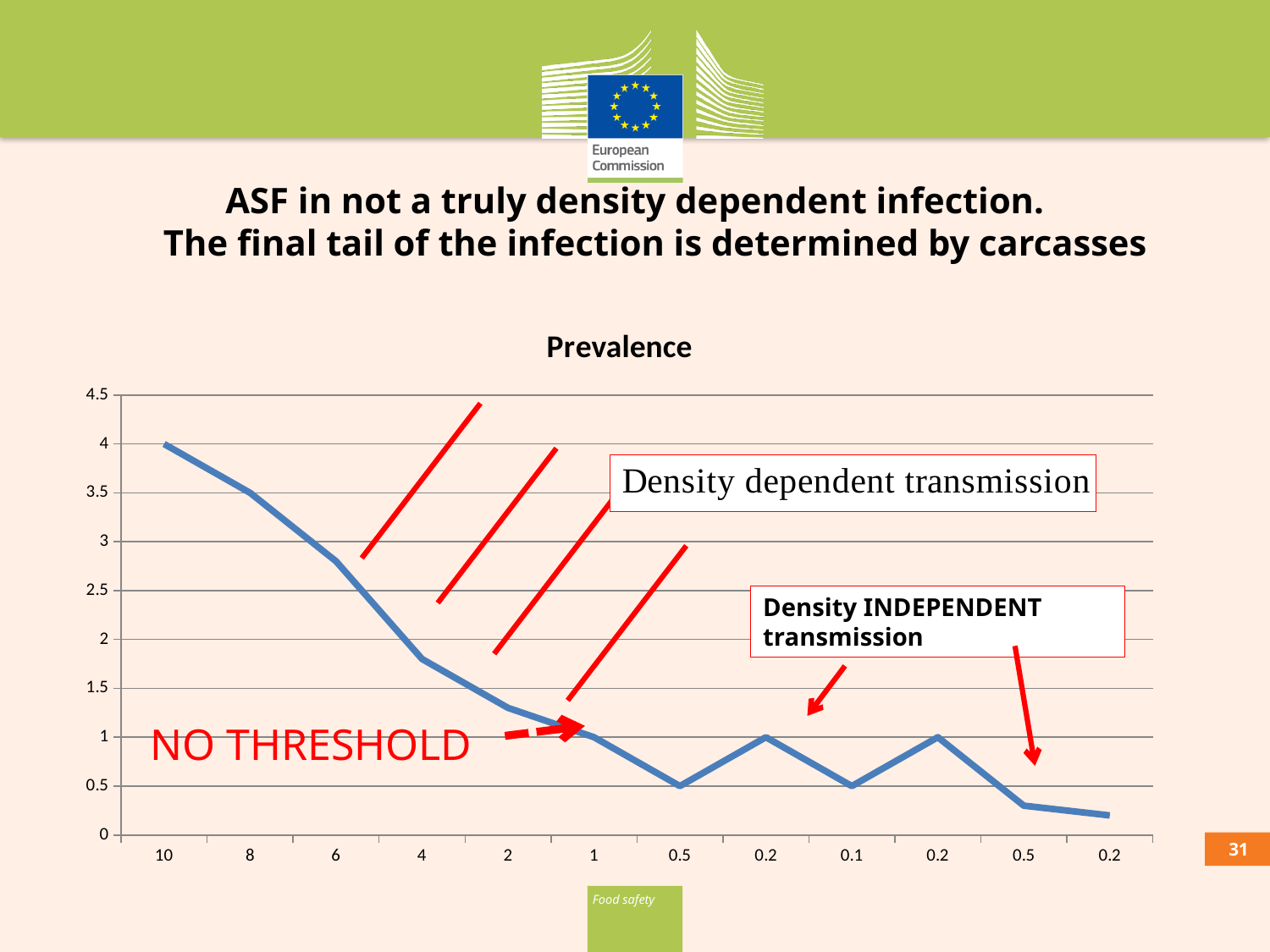
What is the prevalence value at the x-axis category 1? 1 Is the prevalence value at x-axis category 4 greater or less than 2? less How many data points are plotted on the line? 12 At which x-axis category is the prevalence highest? 10 Does the prevalence generally rise or fall from left to right along the x axis? fall What is the prevalence value at the x-axis category 8? 3.5 Is the prevalence value at x-axis category 6 greater or less than 3? less What is the difference between the prevalence values at x-axis categories 10 and 8? 0.5 What is the prevalence value at the x-axis category 10? 4 What is the title of the chart? Prevalence What kind of chart is shown on the slide? line chart What is the prevalence value at the x-axis category 0.1? 0.5